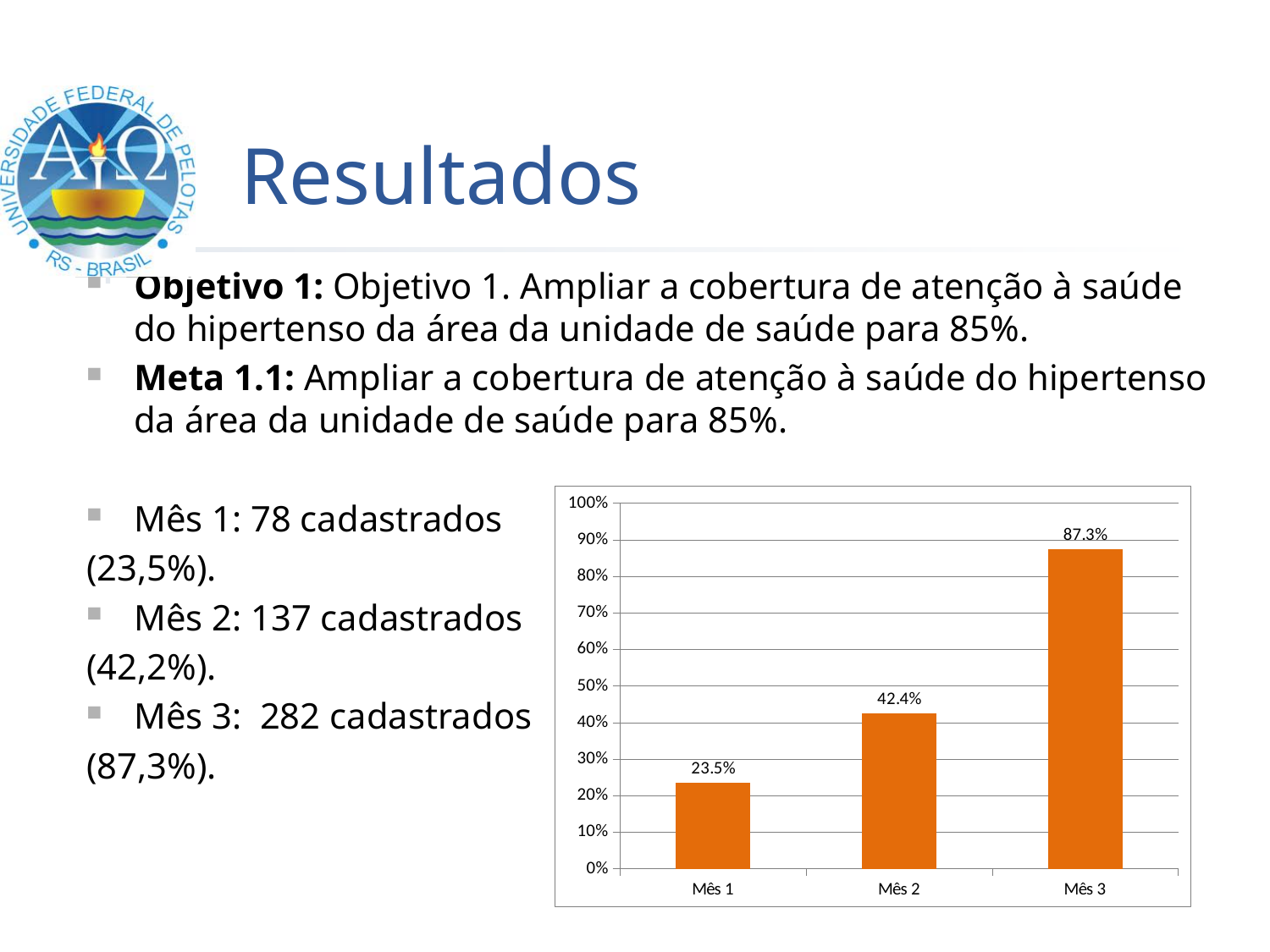
Do the values rise or fall from Mês 1 to Mês 3? rise Is the value for Mês 3 greater or less than 80%? greater What is the value shown for Mês 2 in the chart? 42.4% How many categories are shown on the x axis of the chart? 3 What is the value shown for Mês 1 in the chart? 23.5% Which is larger, the value for Mês 1 or the value for Mês 2? Mês 2 What is the value shown for Mês 3 in the chart? 87.3% What is the difference between the values for Mês 3 and Mês 2? 44.9% What kind of chart is shown on the slide? bar chart Which month has the lowest value in the chart? Mês 1 What is the difference between the values for Mês 2 and Mês 1? 18.9% Which month has the highest value in the chart? Mês 3